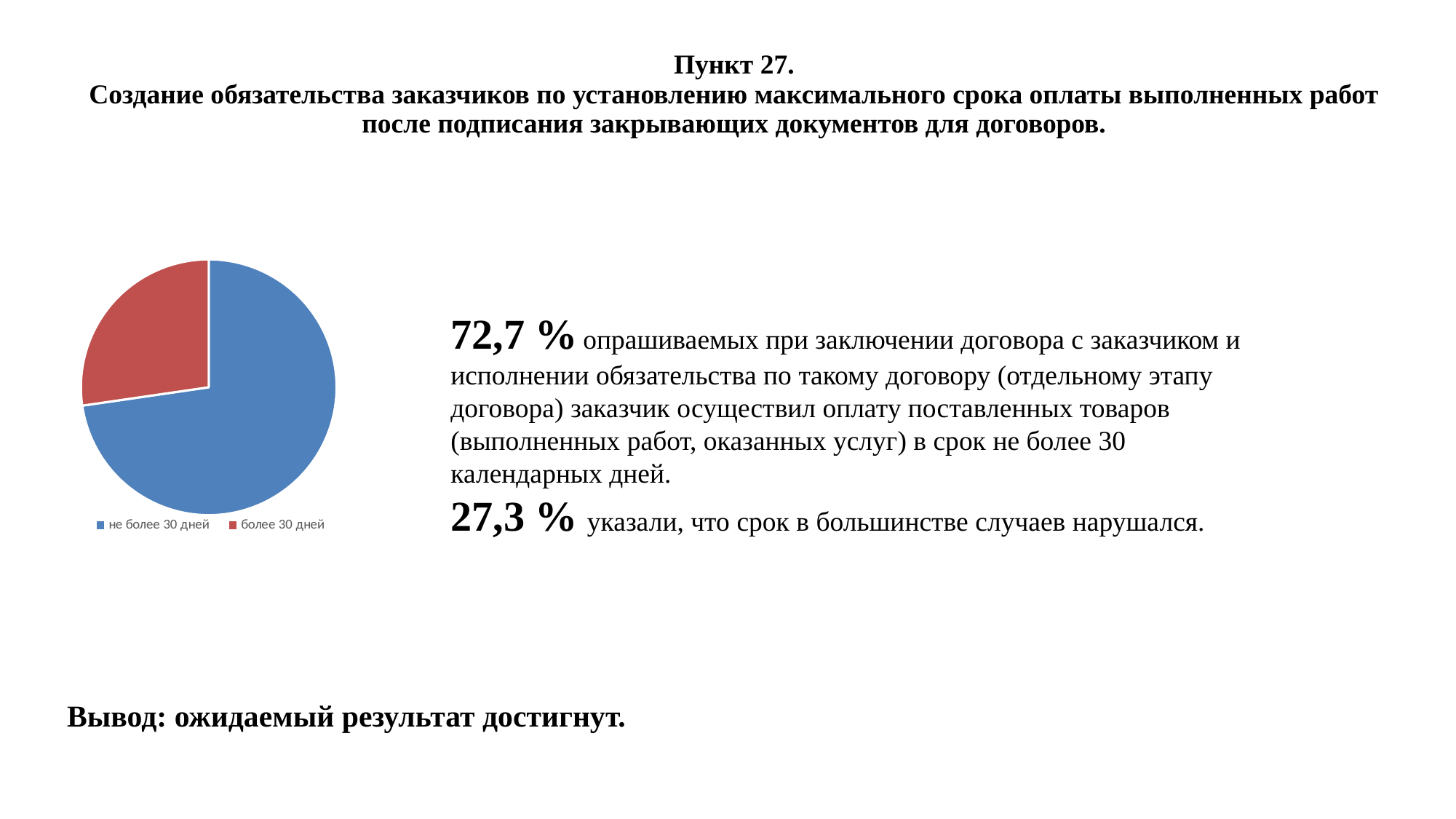
What colour is the "не более 30 дней" slice in the pie chart? blue What kind of chart is shown on the slide? pie chart How many slices does the pie chart have? 2 Which category has the largest slice in the pie chart? не более 30 дней What colour is the "более 30 дней" slice in the pie chart? red What share of the pie does the "не более 30 дней" slice represent, according to the slide? 72,7 % Does the "не более 30 дней" slice take up more or less than half of the pie? more Which category has the smallest slice in the pie chart? более 30 дней How many entries does the legend of the pie chart list? 2 What share of the pie does the "более 30 дней" slice represent, according to the slide? 27,3 % Which slice is larger: "не более 30 дней" or "более 30 дней"? не более 30 дней